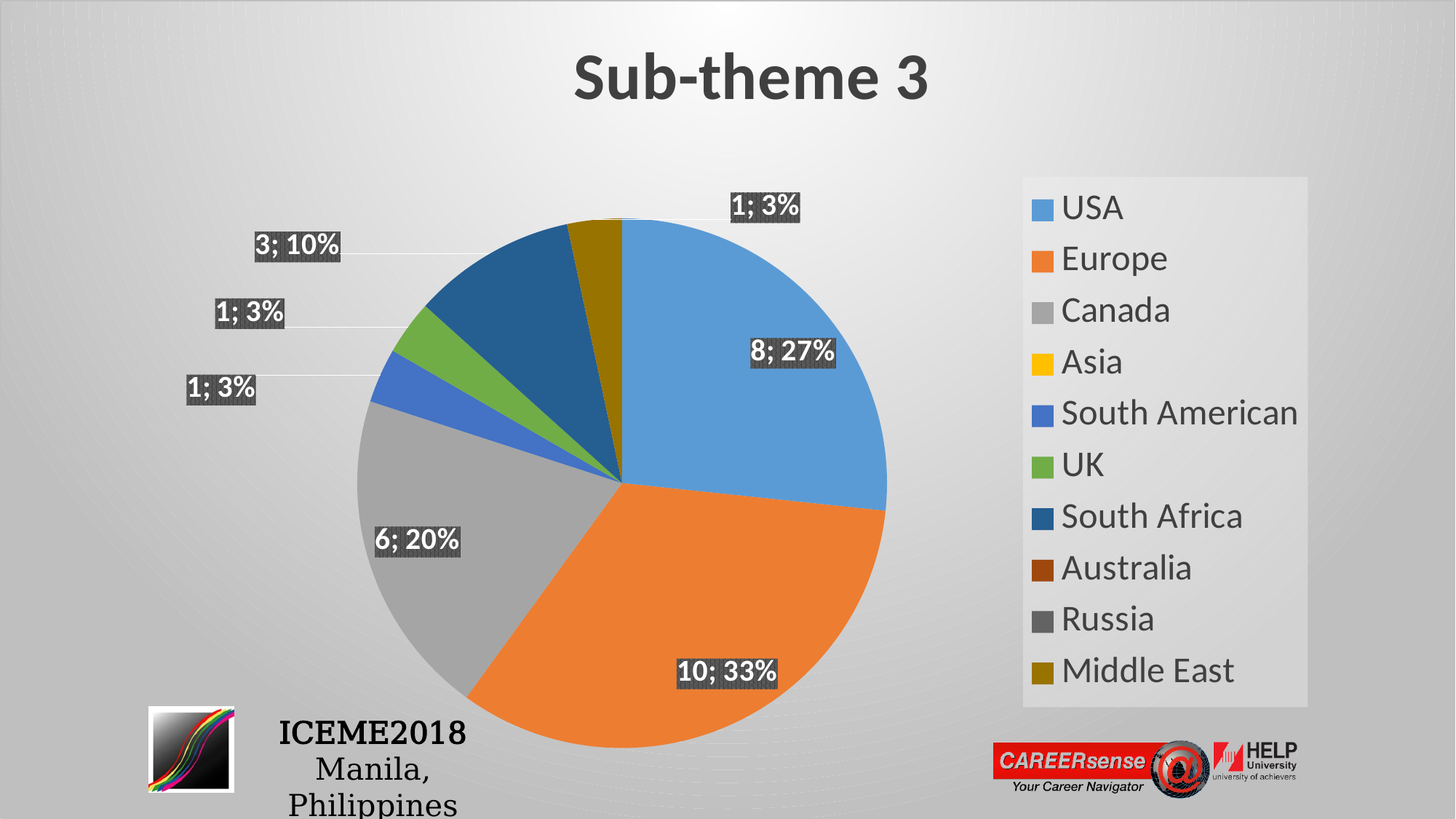
What is the total of all the counts shown on the slice labels? 30 What count is shown on the USA slice? 8 Which slice is larger, South Africa or UK? South Africa What percentage share does the Canada slice show? 20% What is the difference between the counts for Europe and USA? 2 What count and percentage are shown for South Africa? 3; 10% What percentage share does the Europe slice show? 33% Which slice is larger, USA or Canada? USA What kind of chart is shown on the slide? pie chart Which category has the largest slice of the pie? Europe What is the title of the chart? Sub-theme 3 How many entries does the legend list? 10